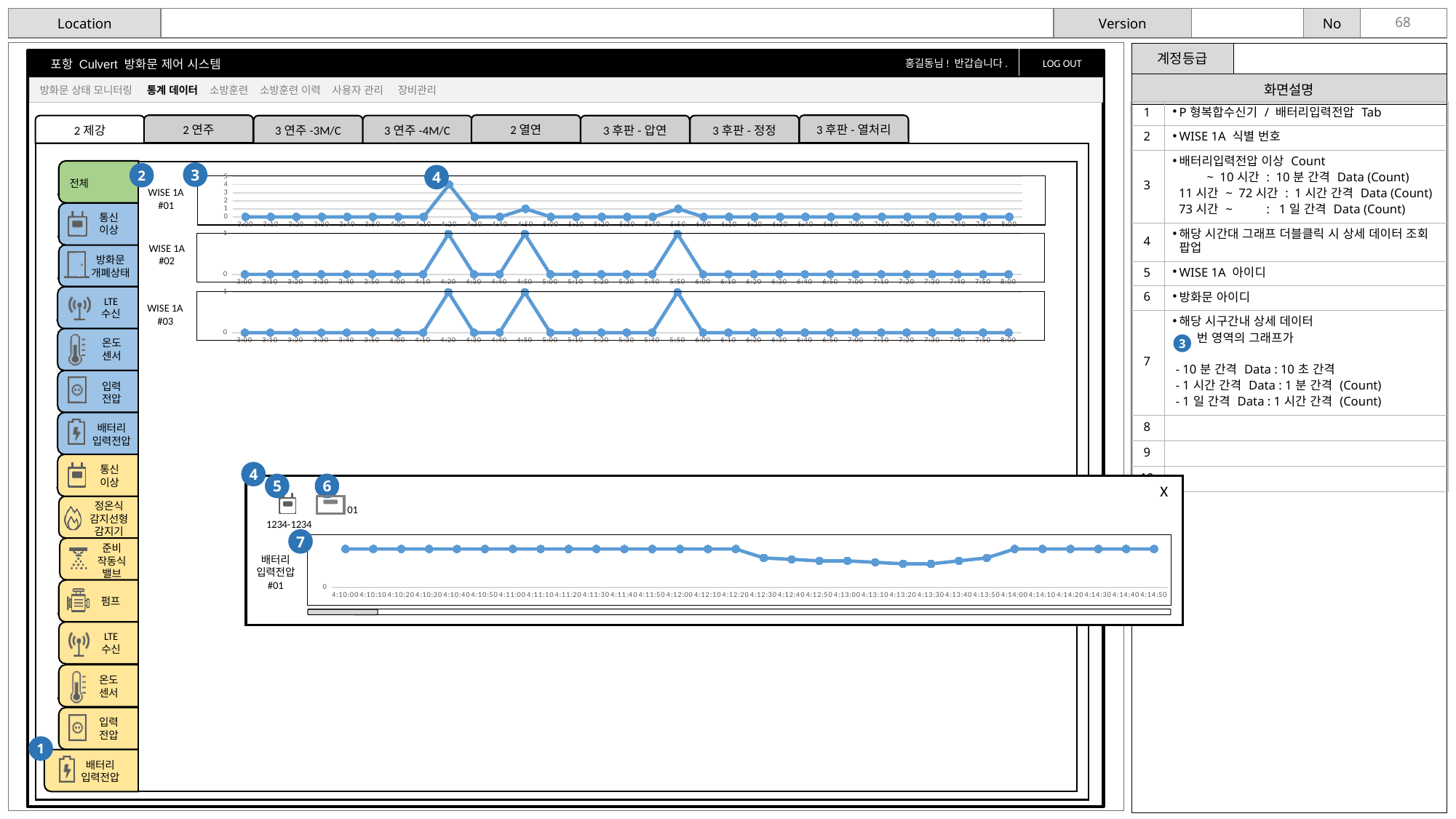
What is the highest y-axis tick shown on the WISE 1A #02 chart? 1 In the WISE 1A #01 chart, which is larger, the value at 4:20 or the value at 5:50? 4:20 How many WISE 1A line charts are shown in the main statistics area (excluding the popup)? 3 In the WISE 1A #02 chart, what is the value at 4:20? 1 What is the highest y-axis tick shown on the WISE 1A #01 chart? 5 In the WISE 1A #01 chart, is the value at 4:20 greater or less than 3? greater What kind of chart is used for the WISE 1A #01 panel? line chart In the WISE 1A #01 chart, is the value at 4:50 greater or less than 3? less In the WISE 1A #02 chart, how many times does the line rise to 1? 3 What is the first time label on the x axis of the popup chart labelled 배터리 입력전압 #01? 4:10:00 In the popup chart labelled 배터리 입력전압 #01, does the line dip or rise in the middle of the time range? dip In the WISE 1A #03 chart, what is the value at 3:00? 0